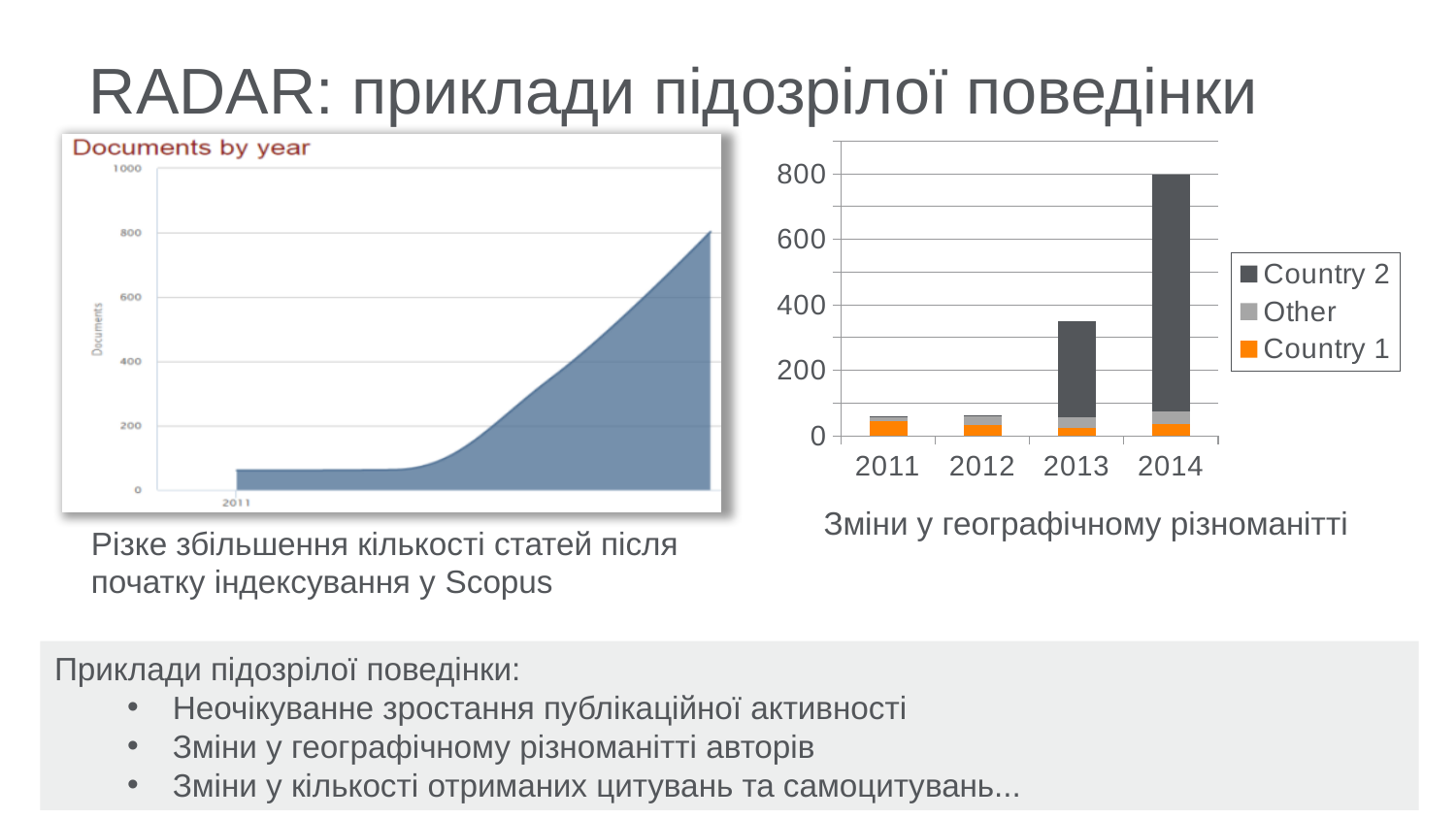
In the left-hand 'Documents by year' chart, do the values rise or fall along the x axis? rise How many series does the legend of the right-hand chart list? 3 In the right-hand chart, is the total for 2011 greater or less than 200? less What kind of chart is the chart on the right of the slide? bar chart Which series are listed in the legend of the right-hand chart? Country 2, Other, Country 1 In the right-hand chart, is the total for 2013 greater or less than 200? greater In the right-hand chart, is the total for 2014 greater or less than 600? greater How many years are shown on the x axis of the right-hand chart? 4 In the right-hand chart, which is larger: the total for 2013 or the total for 2014? 2014 In the right-hand chart, which year has the tallest stacked bar? 2014 In the right-hand chart, which series makes up most of the 2014 bar? Country 2 What is the title of the chart on the left of the slide? Documents by year